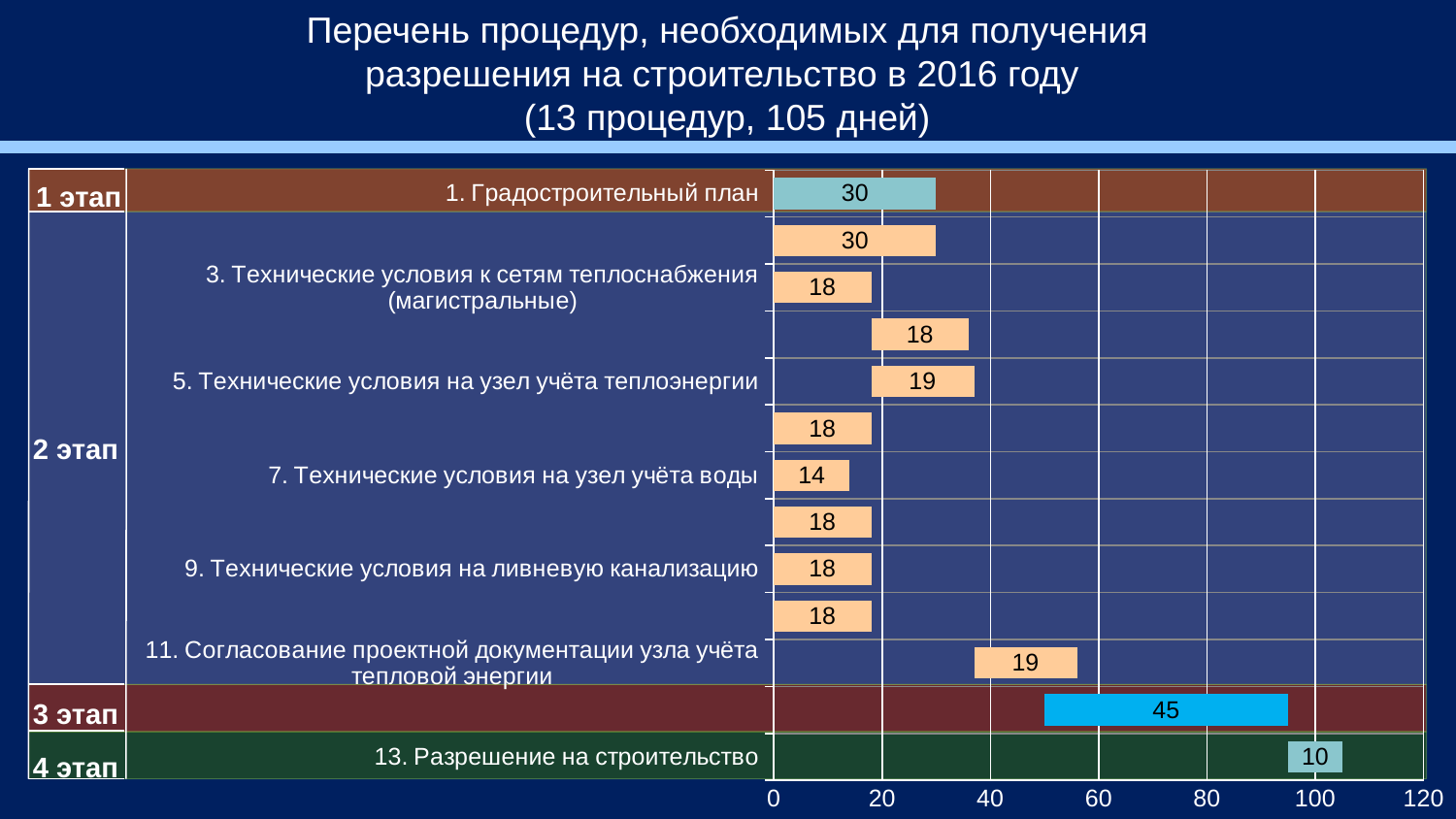
How many bars are plotted on the chart? 13 What value is shown for "5. Технические условия на узел учёта теплоэнергии"? 19 Which stage (этап) contains the longest bar on the chart? 3 этап What kind of chart is shown on the slide? Bar chart Which has the larger value: "7. Технические условия на узел учёта воды" or "9. Технические условия на ливневую канализацию"? 9. Технические условия на ливневую канализацию What is the difference between the values for "1. Градостроительный план" and "13. Разрешение на строительство"? 20 Which labelled procedure has the shortest bar? 13. Разрешение на строительство What value is shown on the bar in the "3 этап" row? 45 What value is shown for "13. Разрешение на строительство"? 10 What value is shown for "1. Градостроительный план"? 30 What value is shown for "11. Согласование проектной документации узла учёта тепловой энергии"? 19 What value is shown for "7. Технические условия на узел учёта воды"? 14